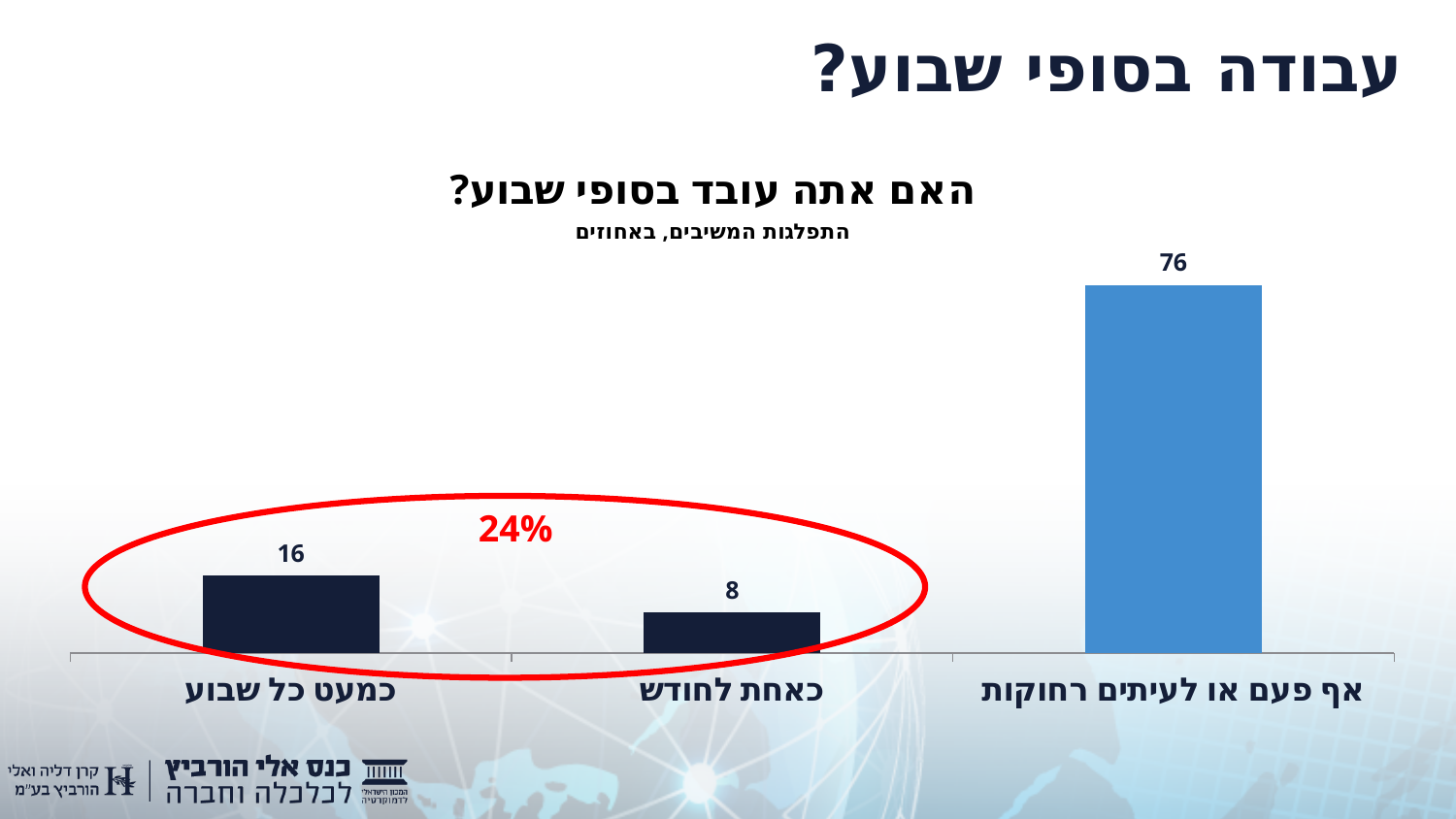
What is the difference between the values for "כמעט כל שבוע" and "כאחת לחודש"? 8 What kind of chart is shown on the slide? Bar chart Which is larger, the value for "כמעט כל שבוע" or the value for "כאחת לחודש"? כמעט כל שבוע What value is shown for the category "כמעט כל שבוע"? 16 Which category has the lowest value? כאחת לחודש What value is shown for the category "אף פעם או לעיתים רחוקות"? 76 What percentage is written in red inside the circled area of the chart? 24% What value is shown for the category "כאחת לחודש"? 8 How many categories are shown in the chart? 3 What is the title of the chart? האם אתה עובד בסופי שבוע? Which category has the highest value? אף פעם או לעיתים רחוקות What is the difference between the values for "אף פעם או לעיתים רחוקות" and "כמעט כל שבוע"? 60